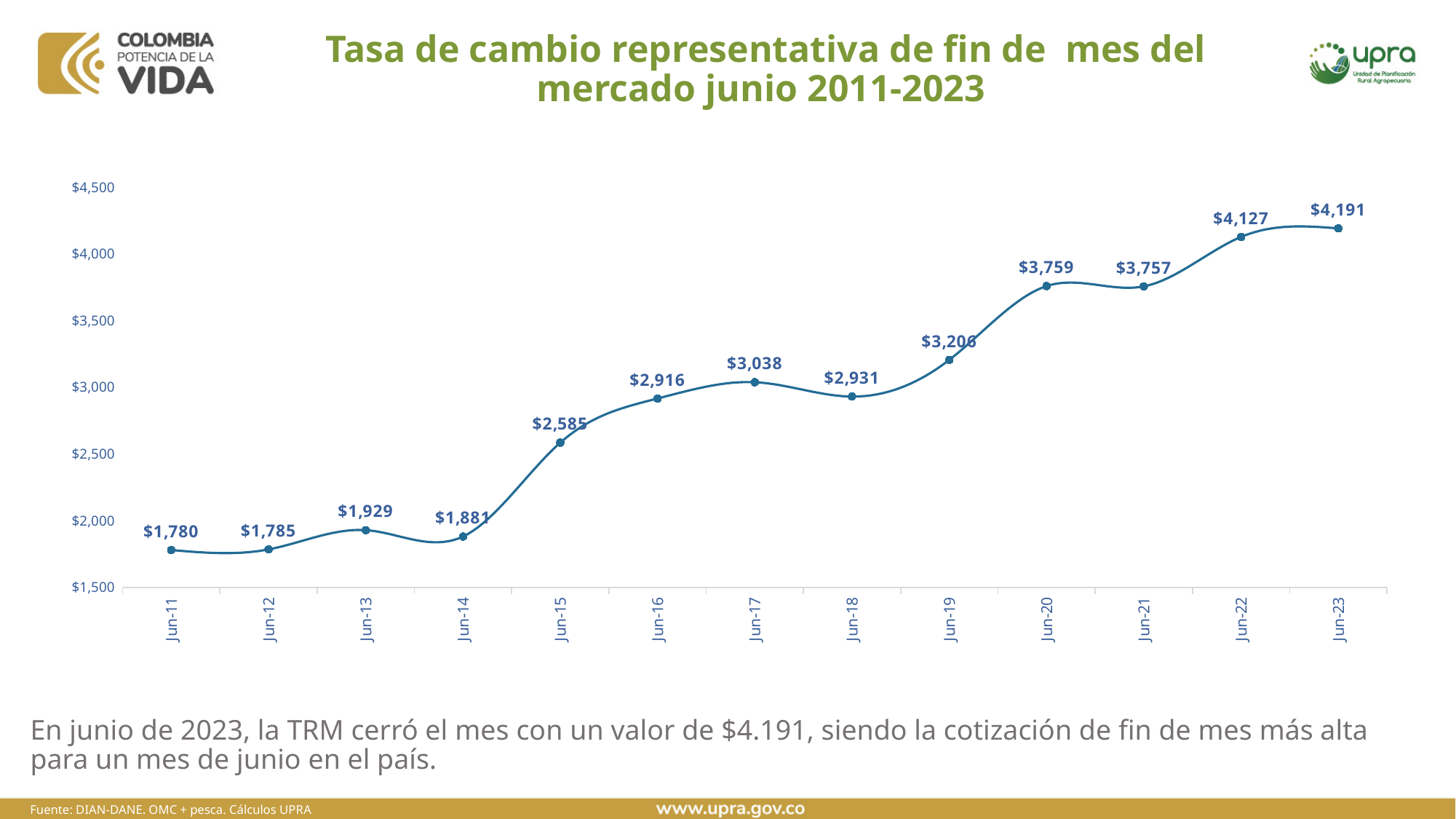
What is the value for Jun-15? $2,585 What kind of chart is shown on the slide? line chart Do the values generally rise or fall from Jun-11 to Jun-23? rise What is the value for Jun-11? $1,780 How many data points are plotted on the chart? 13 Is the value for Jun-19 greater or less than $3,000? greater Which point has the highest value? Jun-23 Which point has the lowest value? Jun-11 What is the difference between the values for Jun-15 and Jun-14? $704 Which is larger, the value for Jun-17 or the value for Jun-18? Jun-17 What is the value for Jun-20? $3,759 What is the difference between the values for Jun-23 and Jun-22? $64